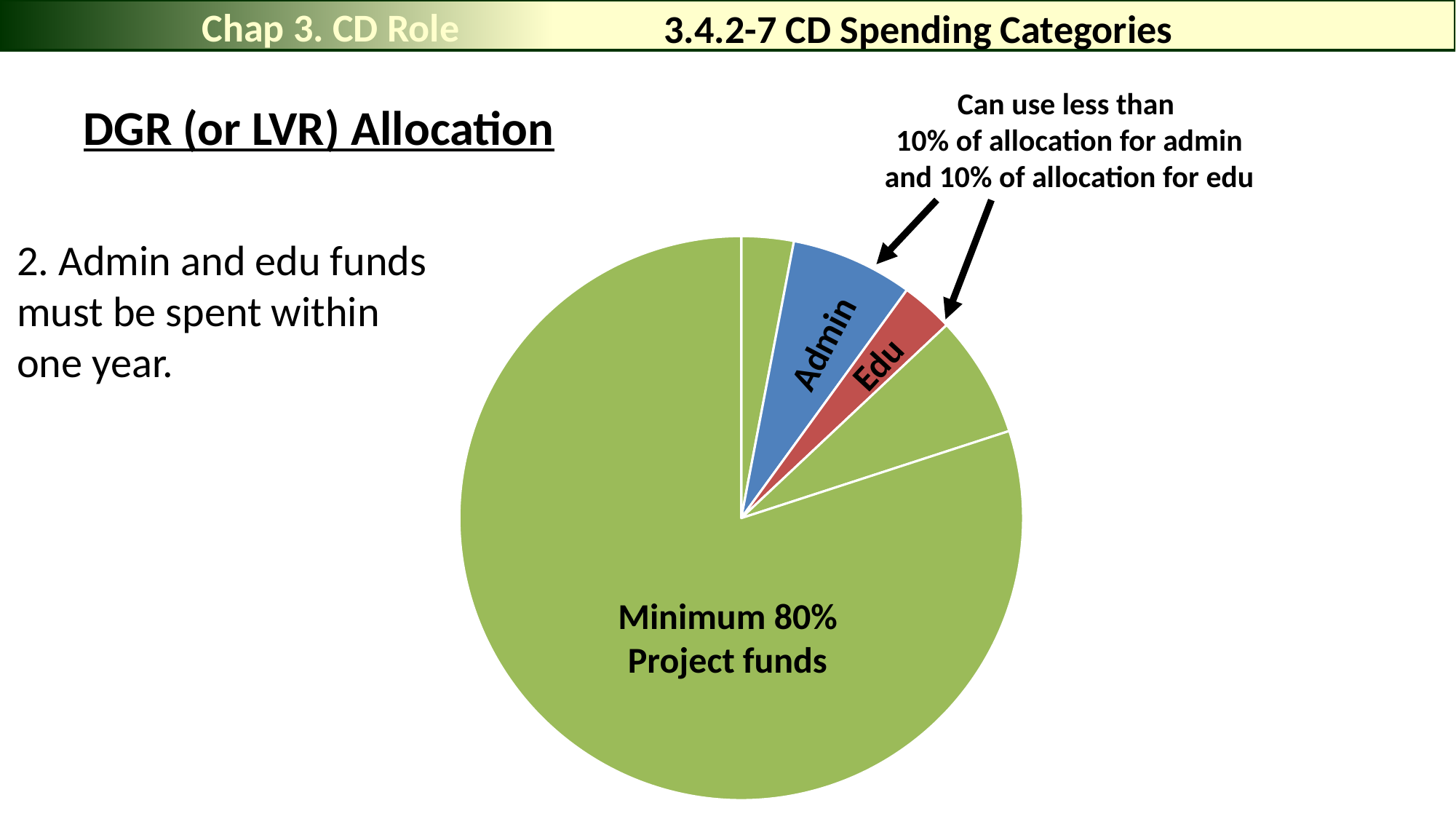
Is the Project funds slice greater or less than 50% of the pie? greater Is the Admin slice greater or less than 25% of the pie? less What colour is the Admin slice in the pie chart? blue Is the Edu slice greater or less than 25% of the pie? less Which slice is larger in the pie chart, Project funds or Admin? Project funds What kind of chart is shown on the slide? pie chart Which slice of the pie chart is the largest? Project funds What share of the allocation is labelled for Project funds in the pie chart? Minimum 80% Which is larger in the pie chart, the Admin slice or the Edu slice? Admin What is the title of the allocation shown in the pie chart? DGR (or LVR) Allocation